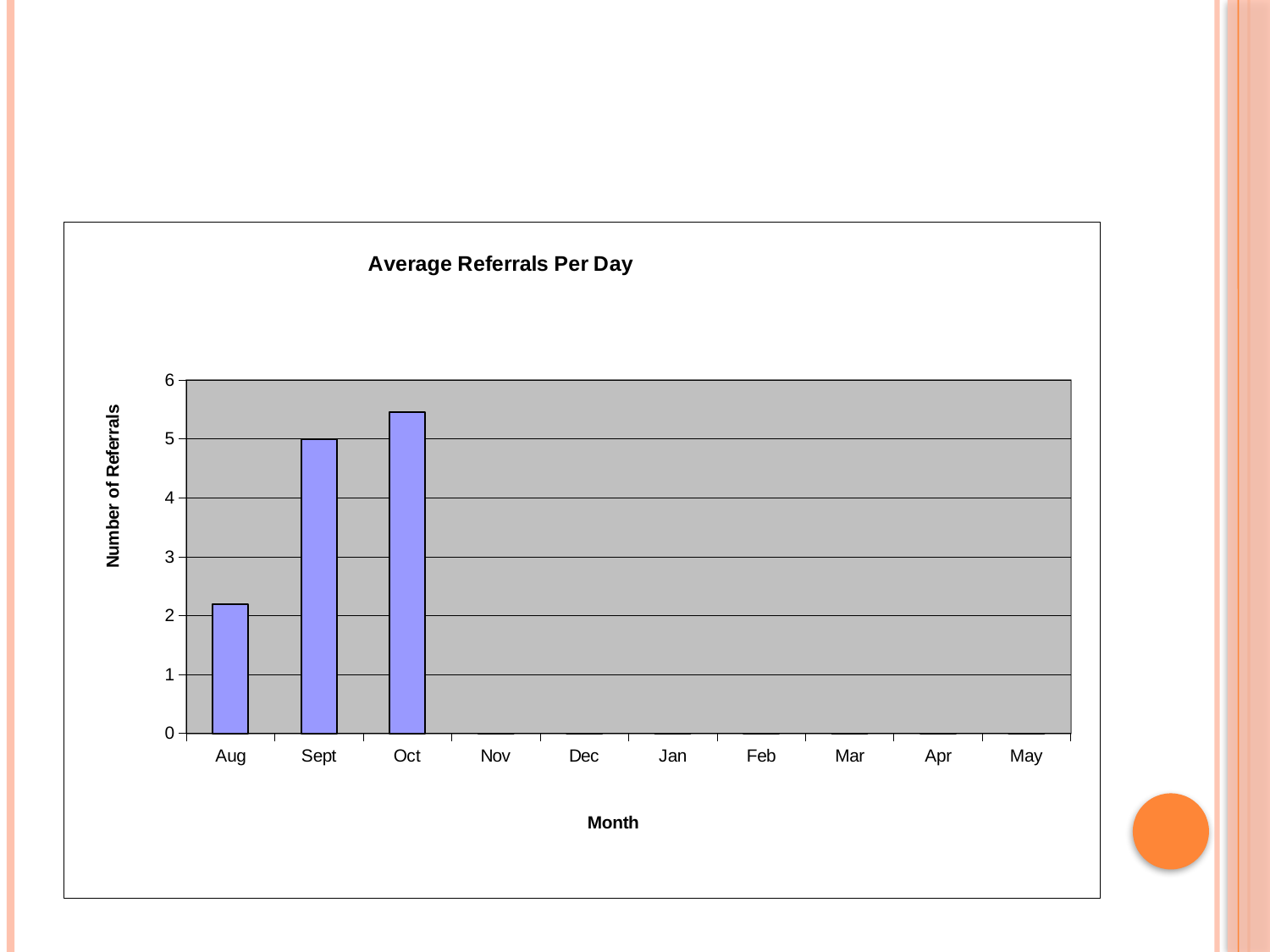
Is the value for Oct greater or less than 5? greater What is the title of the chart? Average Referrals Per Day Among Aug, Sept and Oct, which month has the lowest value? Aug How many months have a visible bar in the chart? 3 Which month has the highest value in the chart? Oct Do the values rise or fall from Aug to Oct? rise Is the value for Aug greater or less than 3? less Which is larger, the value for Aug or the value for Sept? Sept What is the label on the vertical axis of the chart? Number of Referrals Which is larger, the value for Sept or the value for Oct? Oct How many months are listed along the x axis of the chart? 10 What kind of chart is shown on the slide? bar chart